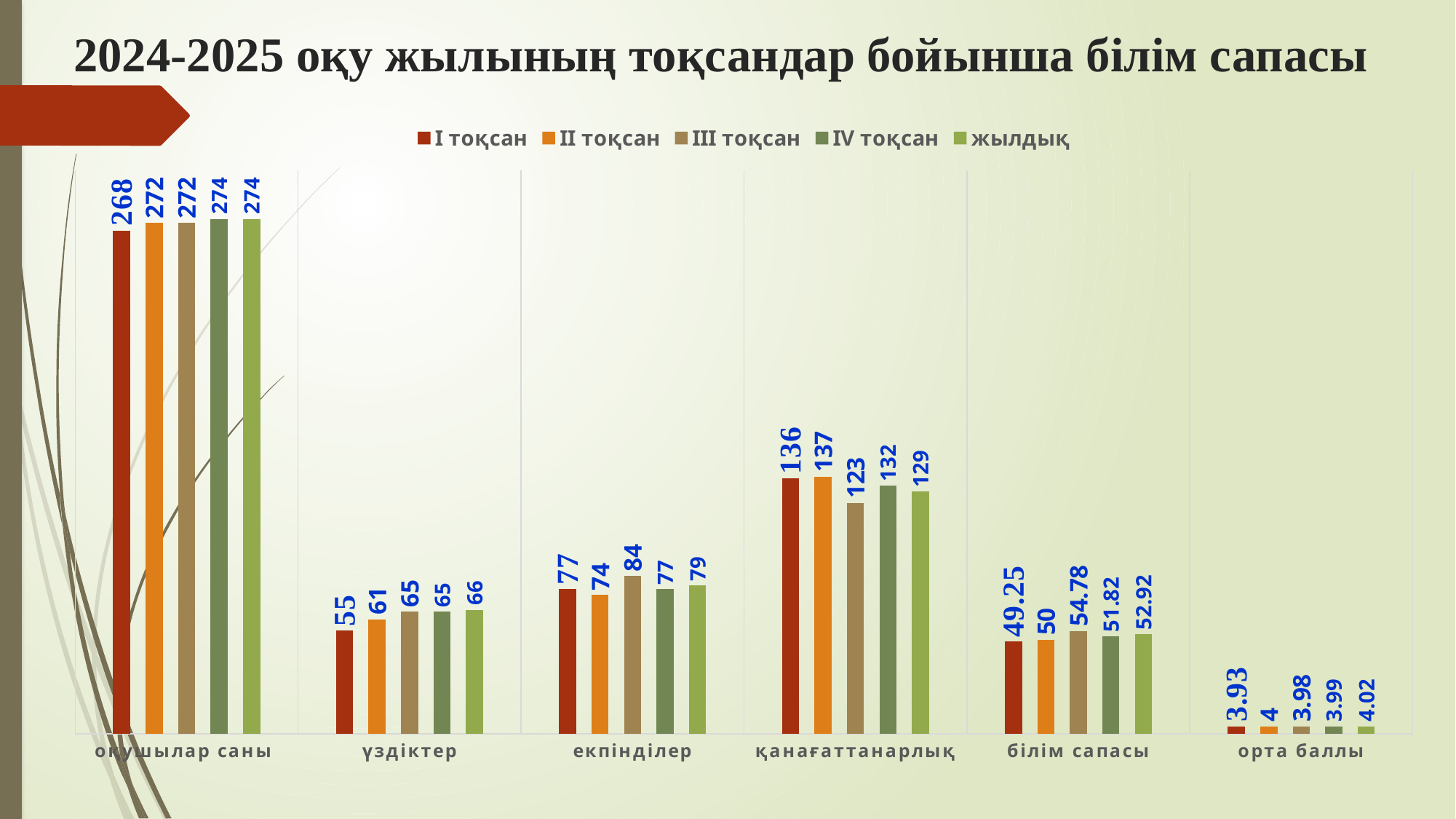
Which is larger in the білім сапасы category: III тоқсан or IV тоқсан? III тоқсан What is the value for III тоқсан in the екпінділер category? 84 What is the title of the slide? 2024-2025 оқу жылының тоқсандар бойынша білім сапасы Which series has the highest value in the қанағаттанарлық category? II тоқсан How many series does the legend list? 5 What is the value for II тоқсан in the орта баллы category? 4 What is the value for I тоқсан in the оқушылар саны category? 268 Which series has the lowest value in the үздіктер category? I тоқсан How many categories are shown on the x axis? 6 What kind of chart is shown on the slide? bar chart What is the value for жылдық in the білім сапасы category? 52.92 What is the difference between the II тоқсан and III тоқсан values in the қанағаттанарлық category? 14